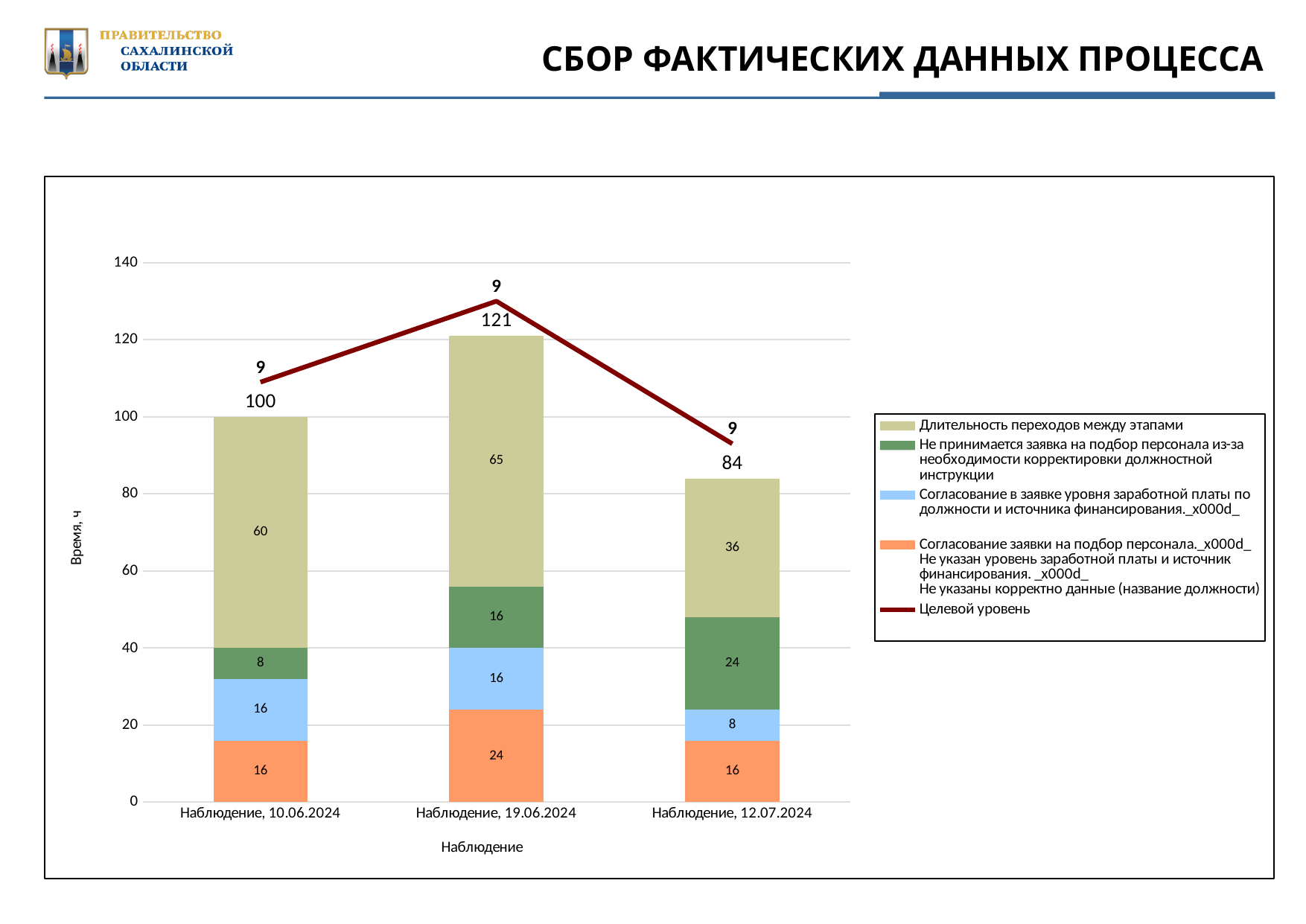
Which observation has the highest stacked bar total? Наблюдение, 19.06.2024 What is the value of the Длительность переходов между этапами segment for Наблюдение, 10.06.2024? 60 What is the difference between the stacked bar totals for Наблюдение, 19.06.2024 and Наблюдение, 12.07.2024? 37 What is the value of the Не принимается заявка на подбор персонала segment (dark green) for Наблюдение, 12.07.2024? 24 What is the total of the stacked bar for Наблюдение, 12.07.2024? 84 Which observation has the lowest stacked bar total? Наблюдение, 12.07.2024 Which is larger: the Длительность переходов между этапами segment for Наблюдение, 19.06.2024 or for Наблюдение, 12.07.2024? Наблюдение, 19.06.2024 What kind of chart is shown on the slide? Stacked bar chart with a line How many series does the legend list? 5 How many observation categories are shown on the x axis? 3 What is the total of the stacked bar for Наблюдение, 19.06.2024? 121 What is the value of the Согласование заявки на подбор персонала segment (orange) for Наблюдение, 19.06.2024? 24